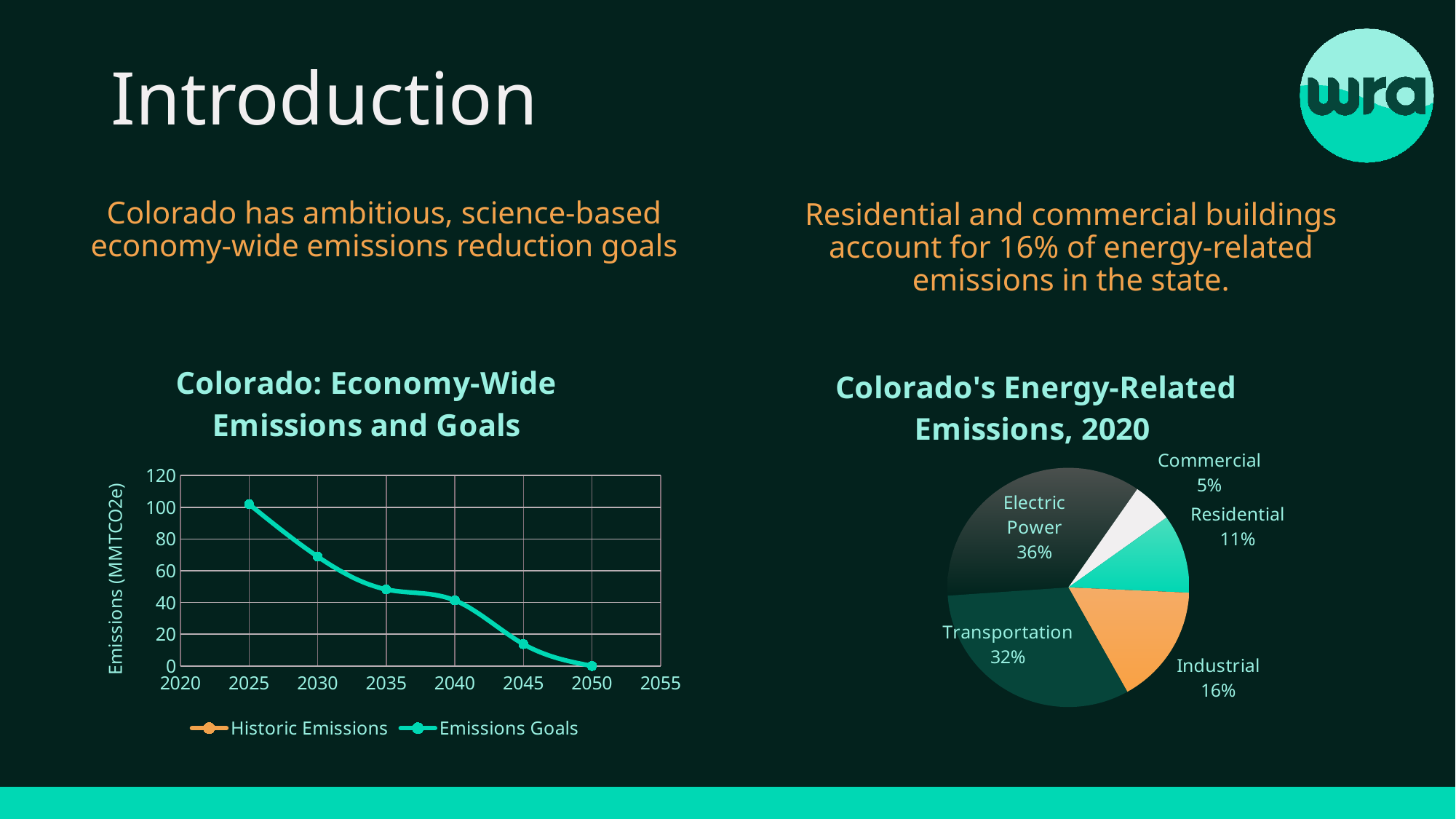
In the pie chart 'Colorado's Energy-Related Emissions, 2020', how many sectors are shown? 5 In the chart 'Colorado: Economy-Wide Emissions and Goals', do the Emissions Goals values rise or fall from 2025 to 2050? Fall In the pie chart 'Colorado's Energy-Related Emissions, 2020', what share does Residential account for? 11% In the pie chart 'Colorado's Energy-Related Emissions, 2020', what share does Electric Power account for? 36% In the pie chart 'Colorado's Energy-Related Emissions, 2020', what share does Transportation account for? 32% In the chart 'Colorado: Economy-Wide Emissions and Goals', how many series does the legend list? 2 In the pie chart 'Colorado's Energy-Related Emissions, 2020', which sector has the smallest share? Commercial In the pie chart 'Colorado's Energy-Related Emissions, 2020', which sector has the largest share? Electric Power What kind of chart is 'Colorado: Economy-Wide Emissions and Goals'? Line chart What kind of chart is 'Colorado's Energy-Related Emissions, 2020'? Pie chart In the pie chart 'Colorado's Energy-Related Emissions, 2020', how many percentage points larger is Industrial than Commercial? 11